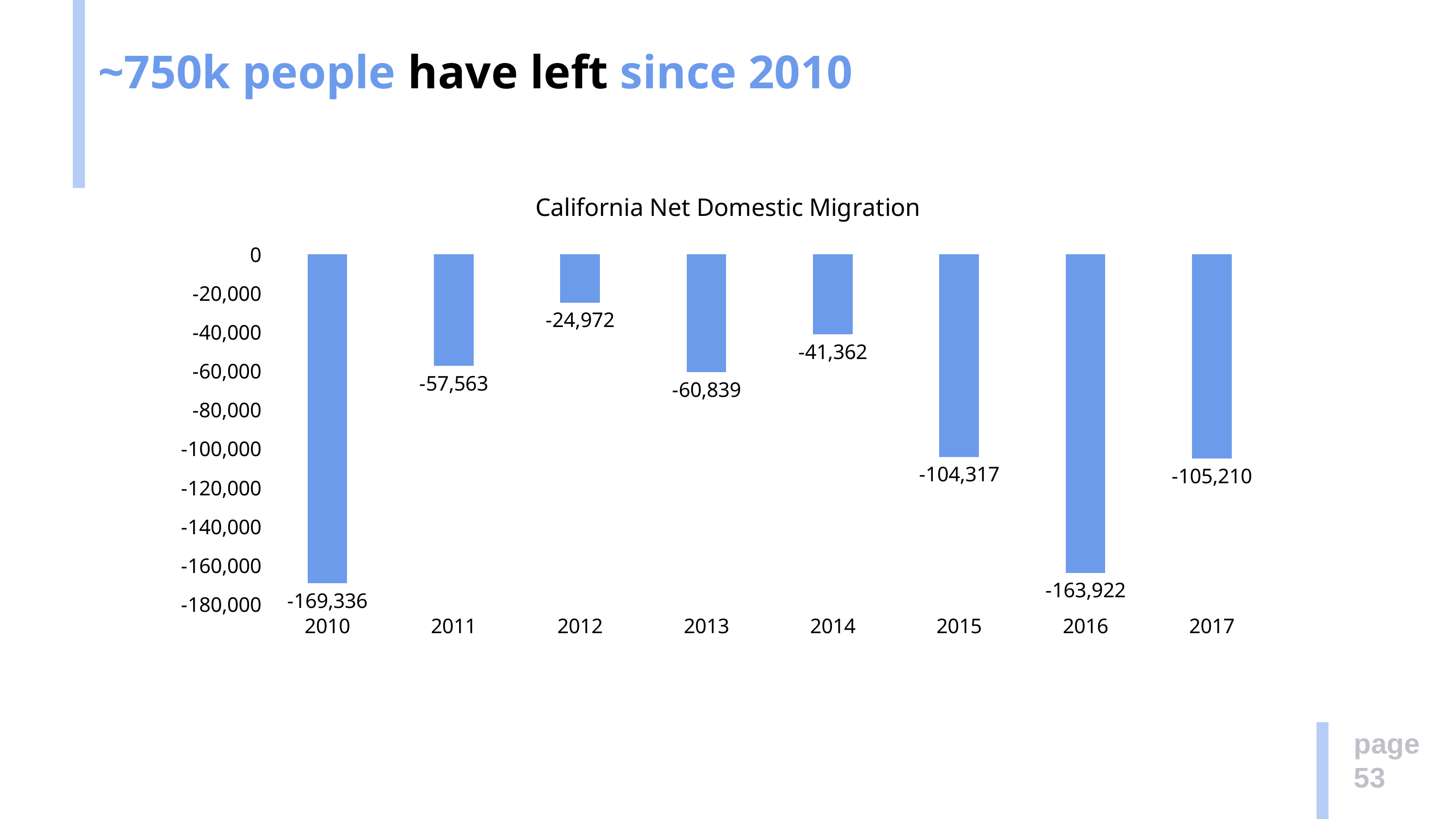
What is the value for 2010 in the California Net Domestic Migration chart? -169,336 In the California Net Domestic Migration chart, which year has the larger net outflow, 2011 or 2014? 2011 Which year has the highest (closest to zero) value in the California Net Domestic Migration chart? 2012 By how much does the value for 2013 differ from the value for 2011 in the California Net Domestic Migration chart? 3,276 What is the title of the chart on the slide? California Net Domestic Migration By how much does the value for 2010 differ from the value for 2016 in the California Net Domestic Migration chart? 5,414 What is the value for 2014 in the California Net Domestic Migration chart? -41,362 What is the value for 2012 in the California Net Domestic Migration chart? -24,972 What kind of chart is the California Net Domestic Migration chart? Bar chart How many years are shown in the California Net Domestic Migration chart? 8 Which year has the lowest (most negative) value in the California Net Domestic Migration chart? 2010 What is the value for 2016 in the California Net Domestic Migration chart? -163,922